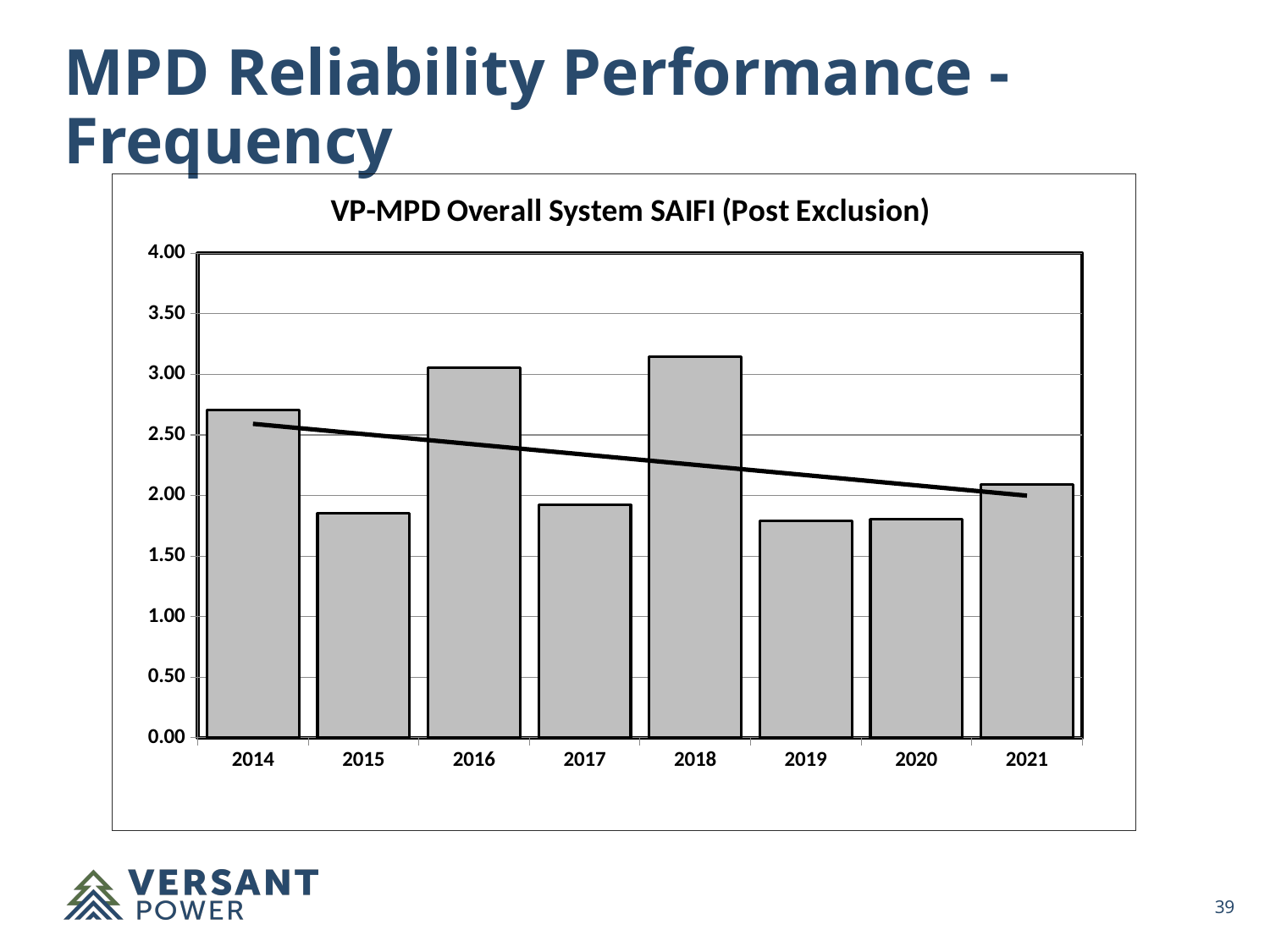
Is the value for 2019 greater or less than 2.00? less Is the value for 2014 greater or less than 2.50? greater What is the title of the chart? VP-MPD Overall System SAIFI (Post Exclusion) Which year has the larger value, 2014 or 2015? 2014 How many years are shown on the x axis of the chart? 8 Is the value for 2015 greater or less than 2.00? less Which year has the highest SAIFI value in the chart? 2018 Does the trend line drawn across the chart rise or fall from 2014 to 2021? fall Which year has the larger value, 2016 or 2017? 2016 What kind of chart is shown on the slide? bar chart